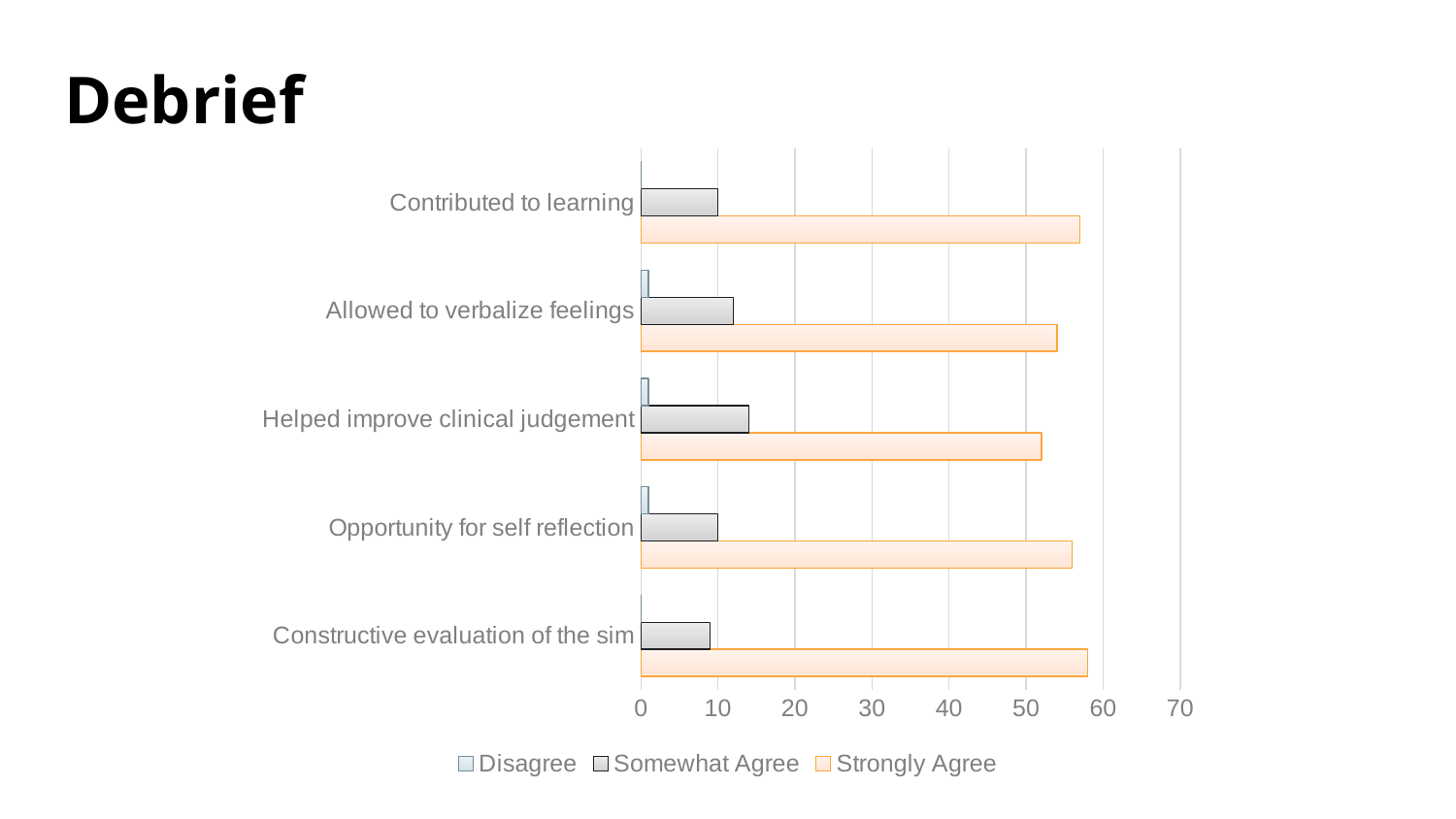
Is the Strongly Agree value for Contributed to learning greater or less than 50? greater What are the three series listed in the legend? Disagree, Somewhat Agree, Strongly Agree How many series does the legend list? 3 What kind of chart is shown on the slide? bar chart Which is larger: the Strongly Agree value for Contributed to learning or for Helped improve clinical judgement? Contributed to learning Which is larger: the Somewhat Agree value for Helped improve clinical judgement or for Contributed to learning? Helped improve clinical judgement Is the Strongly Agree value for Helped improve clinical judgement greater or less than 60? less How many categories are shown on the chart? 5 Is the Strongly Agree value for Constructive evaluation of the sim greater or less than 50? greater What is the title of the slide? Debrief